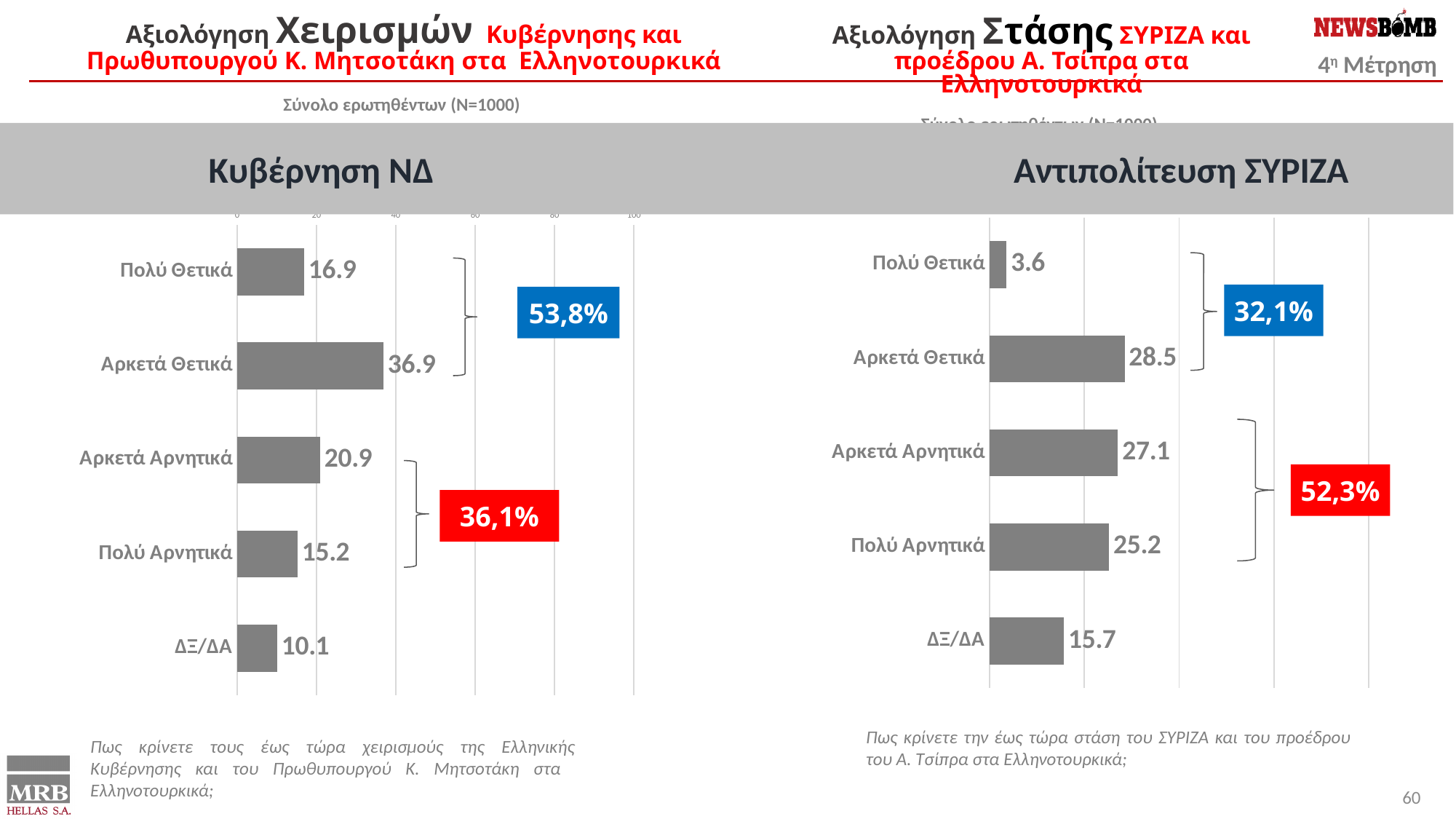
In the Κυβέρνηση ΝΔ chart, which category has the highest value? Αρκετά Θετικά In the Κυβέρνηση ΝΔ chart, what combined percentage is shown in the blue box for the positive categories? 53,8% In the Αντιπολίτευση ΣΥΡΙΖΑ chart, what combined percentage is shown in the red box for the negative categories? 52,3% In the Αντιπολίτευση ΣΥΡΙΖΑ chart, which category has the lowest value? Πολύ Θετικά In the Αντιπολίτευση ΣΥΡΙΖΑ chart, what is the value for Πολύ Θετικά? 3.6 What kind of chart is the Αντιπολίτευση ΣΥΡΙΖΑ chart? Bar chart In the Αντιπολίτευση ΣΥΡΙΖΑ chart, which is larger: Αρκετά Αρνητικά or Πολύ Αρνητικά? Αρκετά Αρνητικά In the Αντιπολίτευση ΣΥΡΙΖΑ chart, what is the value for ΔΞ/ΔΑ? 15.7 In the Κυβέρνηση ΝΔ chart, which category has the lowest value? ΔΞ/ΔΑ How many categories does the Κυβέρνηση ΝΔ chart show? 5 In the Κυβέρνηση ΝΔ chart, what is the value for Αρκετά Θετικά? 36.9 In the Κυβέρνηση ΝΔ chart, what is the difference between Αρκετά Θετικά and Πολύ Θετικά? 20